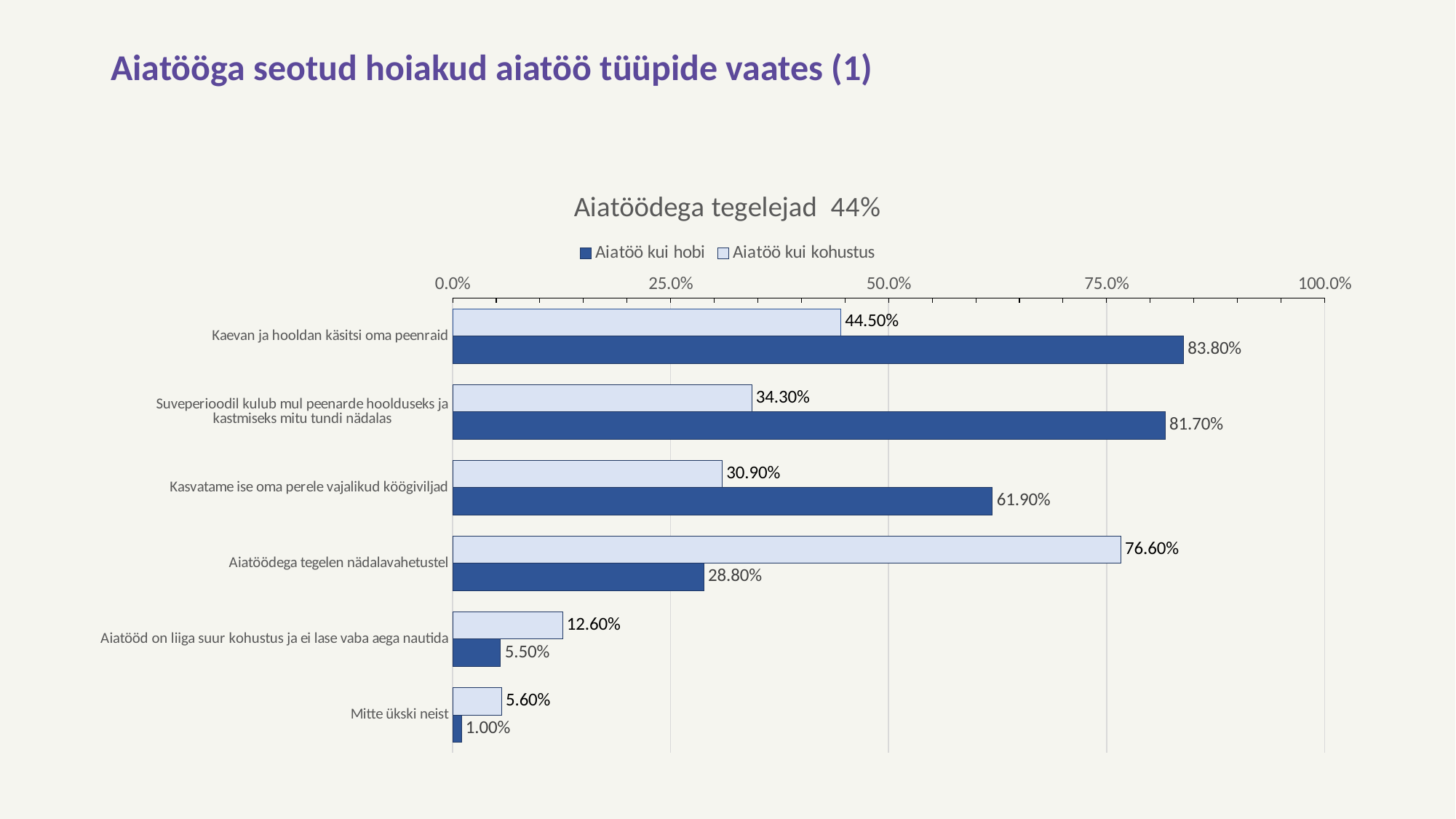
What kind of chart is shown on the slide? Bar chart Which category has the lowest value for "Aiatöö kui kohustus"? Mitte ükski neist What is the value for "Aiatöö kui kohustus" for "Kasvatame ise oma perele vajalikud köögiviljad"? 30.90% How many categories are shown on the chart? 6 What is the value for "Aiatöö kui hobi" for "Kaevan ja hooldan käsitsi oma peenraid"? 83.80% Which category has the highest value for "Aiatöö kui hobi"? Kaevan ja hooldan käsitsi oma peenraid What is the title of the chart? Aiatöödega tegelejad 44% How many series does the legend list? 2 What is the value for "Aiatöö kui kohustus" for "Aiatöödega tegelen nädalavahetustel"? 76.60% What is the difference between the "Aiatöö kui hobi" and "Aiatöö kui kohustus" values for "Kasvatame ise oma perele vajalikud köögiviljad"? 31.00% What is the value for "Aiatöö kui hobi" for "Mitte ükski neist"? 1.00% For "Aiatöödega tegelen nädalavahetustel", which series has the larger value, "Aiatöö kui hobi" or "Aiatöö kui kohustus"? Aiatöö kui kohustus